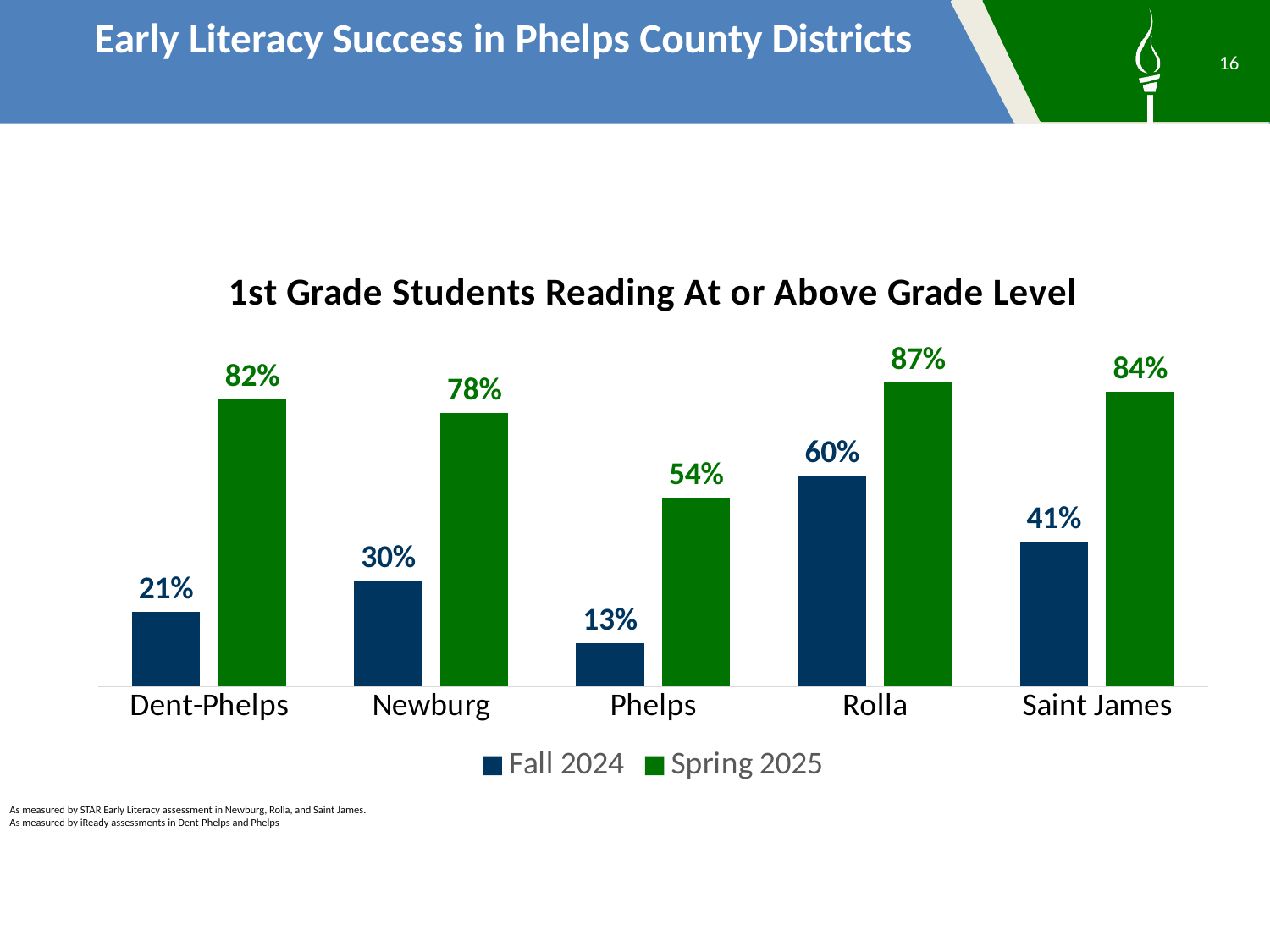
What is the difference between the Spring 2025 and Fall 2024 values for Dent-Phelps? 61% How many districts are shown on the x axis? 5 Which district has the highest Spring 2025 value? Rolla What is the Fall 2024 value for Phelps? 13% What is the Fall 2024 value for Saint James? 41% Which is larger: the Fall 2024 value for Newburg or the Fall 2024 value for Saint James? Saint James How many series does the legend list? 2 Which district has the lowest Fall 2024 value? Phelps What kind of chart is shown on the slide? Bar chart What is the title of the chart? 1st Grade Students Reading At or Above Grade Level What is the Spring 2025 value for Rolla? 87% What is the difference between the Spring 2025 values for Rolla and Phelps? 33%